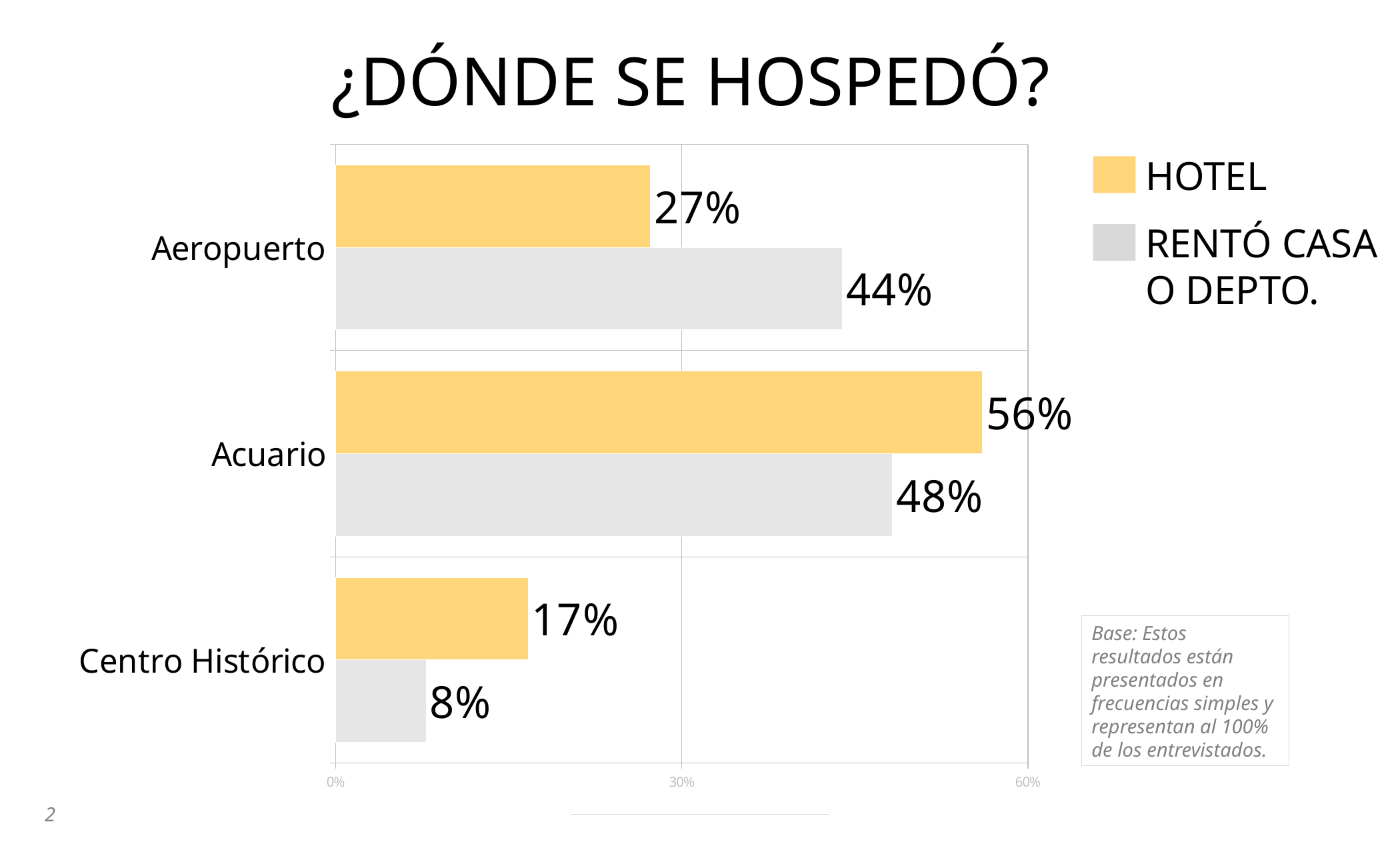
What is the HOTEL value for Centro Histórico? 17% What is the difference between the RENTÓ CASA O DEPTO. and HOTEL values for Aeropuerto? 17% What is the RENTÓ CASA O DEPTO. value for Centro Histórico? 8% Which category has the lowest RENTÓ CASA O DEPTO. value? Centro Histórico For Acuario, which is larger: HOTEL or RENTÓ CASA O DEPTO.? HOTEL What is the RENTÓ CASA O DEPTO. value for Aeropuerto? 44% What is the title of the chart? ¿DÓNDE SE HOSPEDÓ? What kind of chart is shown on the slide? Bar chart How many series does the legend list? 2 How many categories are shown on the chart? 3 Which category has the highest HOTEL value? Acuario What is the HOTEL value for Acuario? 56%